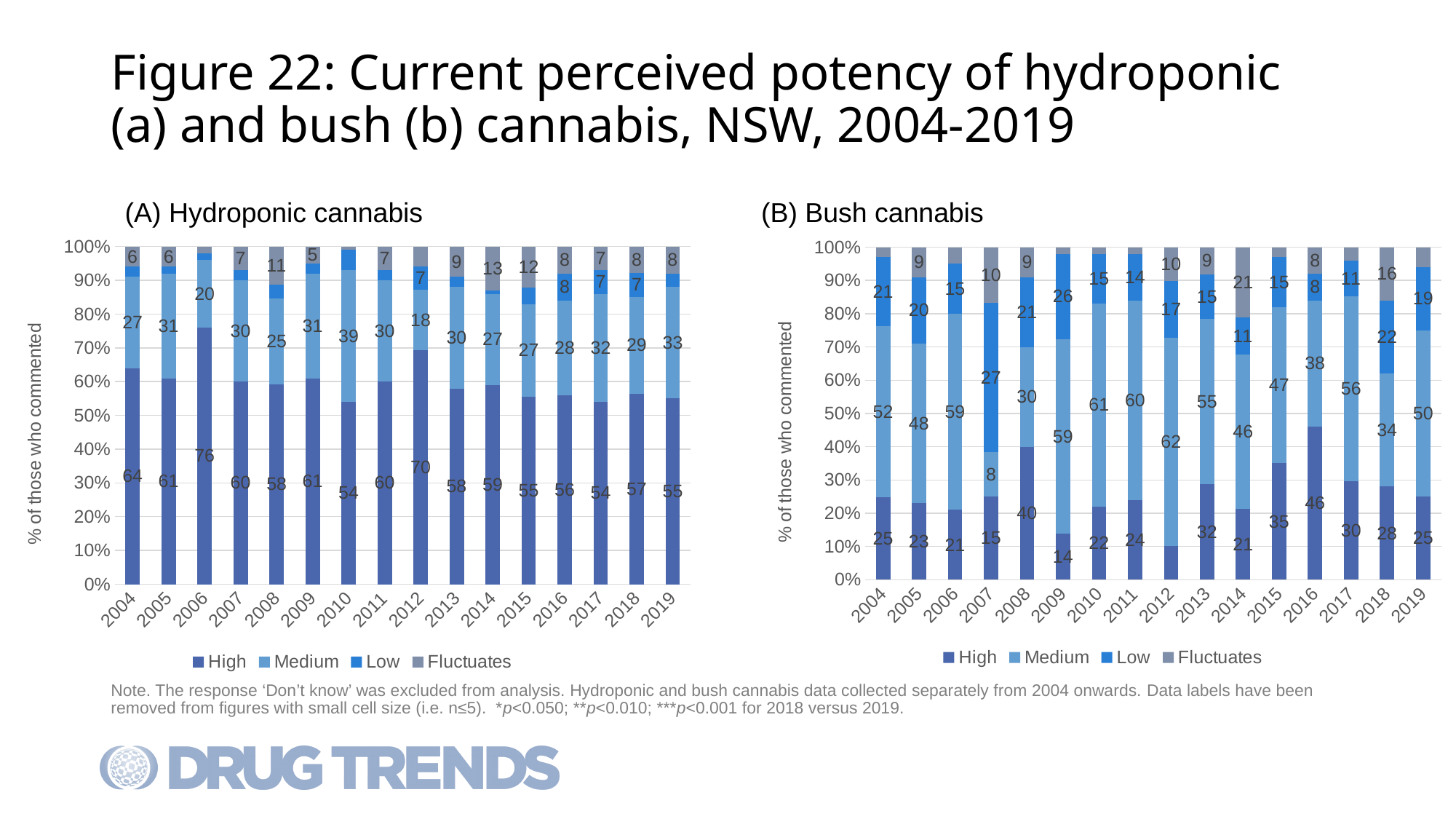
In the (B) Bush cannabis chart, what is the Fluctuates value for 2014? 21 In the (A) Hydroponic cannabis chart, is the top of the High segment for 2006 greater or less than 70%? greater In the (B) Bush cannabis chart, which year has the highest High value? 2016 How many series does the legend of the (A) Hydroponic cannabis chart list? 4 In the (A) Hydroponic cannabis chart, what percentage rated potency as High in 2006? 76 In the (B) Bush cannabis chart, what percentage rated potency as Medium in 2012? 62 In the (A) Hydroponic cannabis chart, which year has the highest High value? 2006 In the (B) Bush cannabis chart, which is larger: the Low value for 2009 or for 2016? 2009 What kind of chart is the (B) Bush cannabis chart? Stacked bar chart How many years are shown on the x axis of the (B) Bush cannabis chart? 16 In the (B) Bush cannabis chart, which year has the lowest Medium value? 2007 In the (A) Hydroponic cannabis chart, what is the difference between the High values for 2006 and 2012? 6